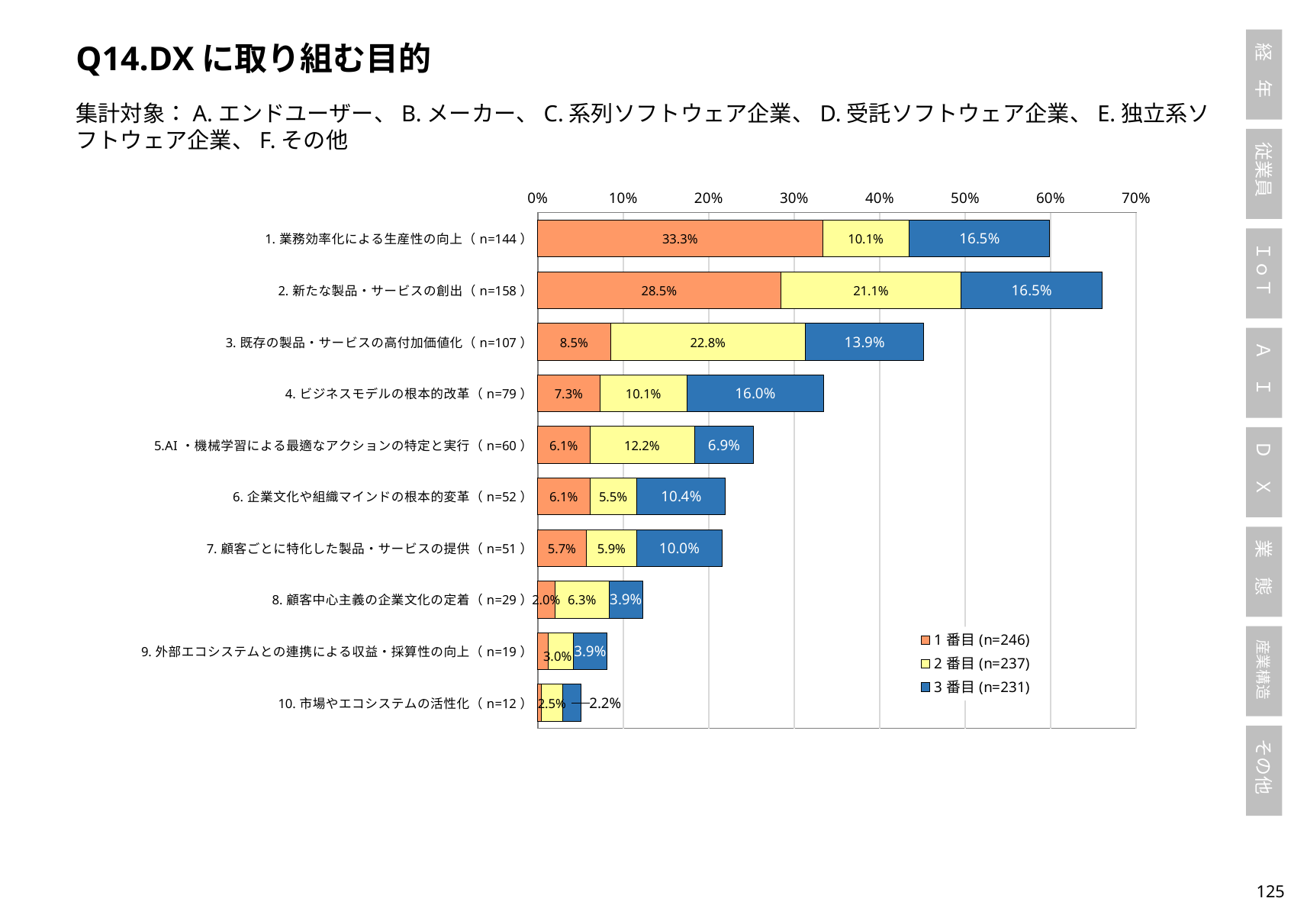
Is the total stacked bar for 2. 新たな製品・サービスの創出 greater or less than 60%? greater What kind of chart is shown on the slide? Stacked bar chart Which is larger: the 2番目 value for 2. 新たな製品・サービスの創出 or for 3. 既存の製品・サービスの高付加価値化? 3. 既存の製品・サービスの高付加価値化 Which category has the highest 1番目 value? 1. 業務効率化による生産性の向上 What is the 1番目 value for 1. 業務効率化による生産性の向上? 33.3% How many series does the legend list? 3 What is the 3番目 value for 4. ビジネスモデルの根本的改革? 16.0% How many categories are shown on the chart? 10 What is the total of the stacked bar for 4. ビジネスモデルの根本的改革? 33.4% What is the difference between the 1番目 values for 1. 業務効率化による生産性の向上 and 2. 新たな製品・サービスの創出? 4.8% What is the 2番目 value for 3. 既存の製品・サービスの高付加価値化? 22.8% Which category has the lowest 3番目 value? 10. 市場やエコシステムの活性化